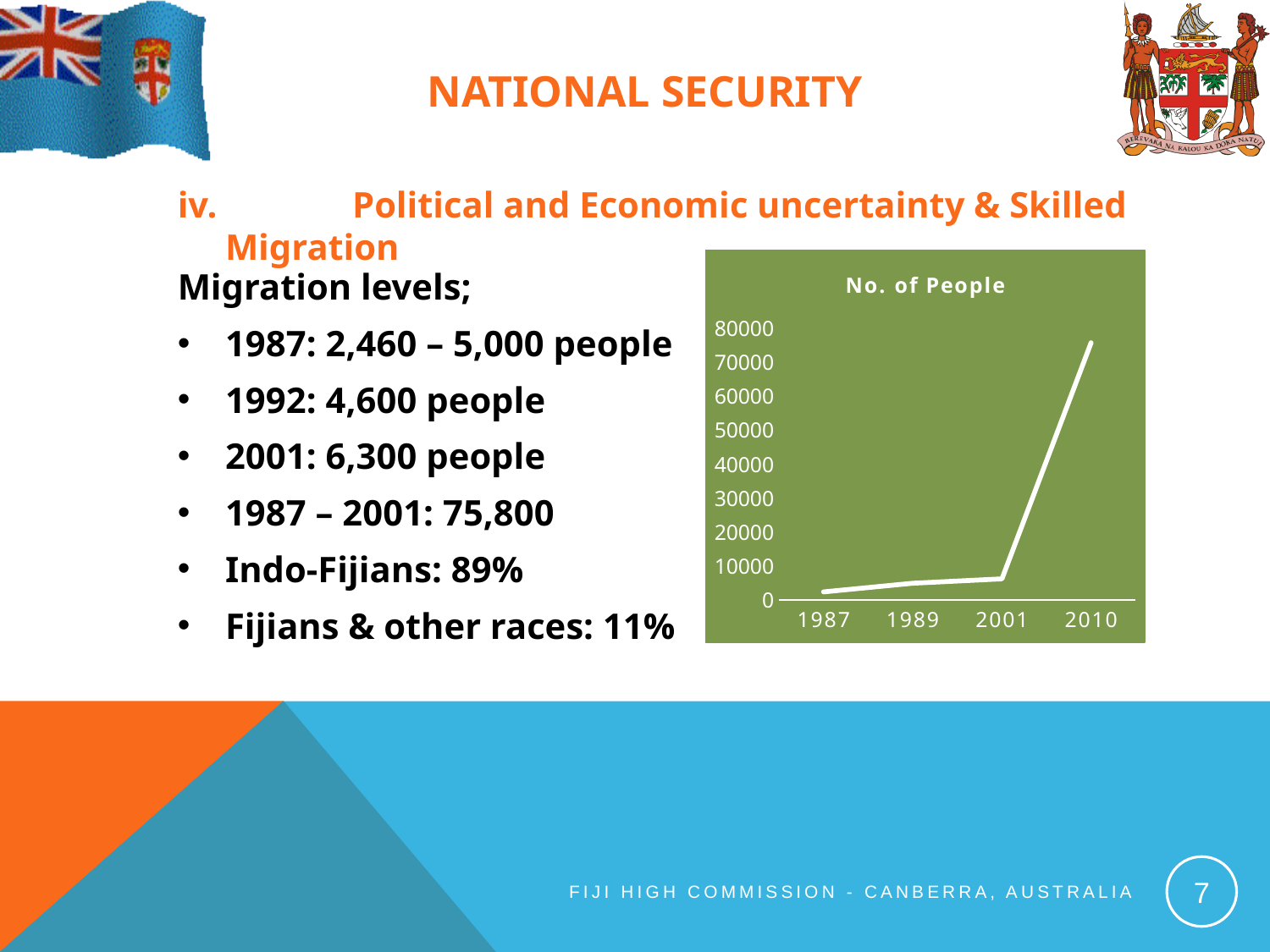
Which is larger, the value for 2010 or the value for 2001? 2010 Is the value for 1987 greater or less than 10000? less What is the title of the chart? No. of People Which year is shown last on the x axis of the chart? 2010 Is the value for 2001 greater or less than 10000? less What is the highest value shown on the y axis of the chart? 80000 Do the values in the chart rise or fall from 1987 to 2010? rise Is the value for 2010 greater or less than 70000? greater Which year has the lowest value in the chart? 1987 How many years are shown on the x axis of the chart? 4 What kind of chart is shown on the slide? line chart Which year has the highest value in the chart? 2010